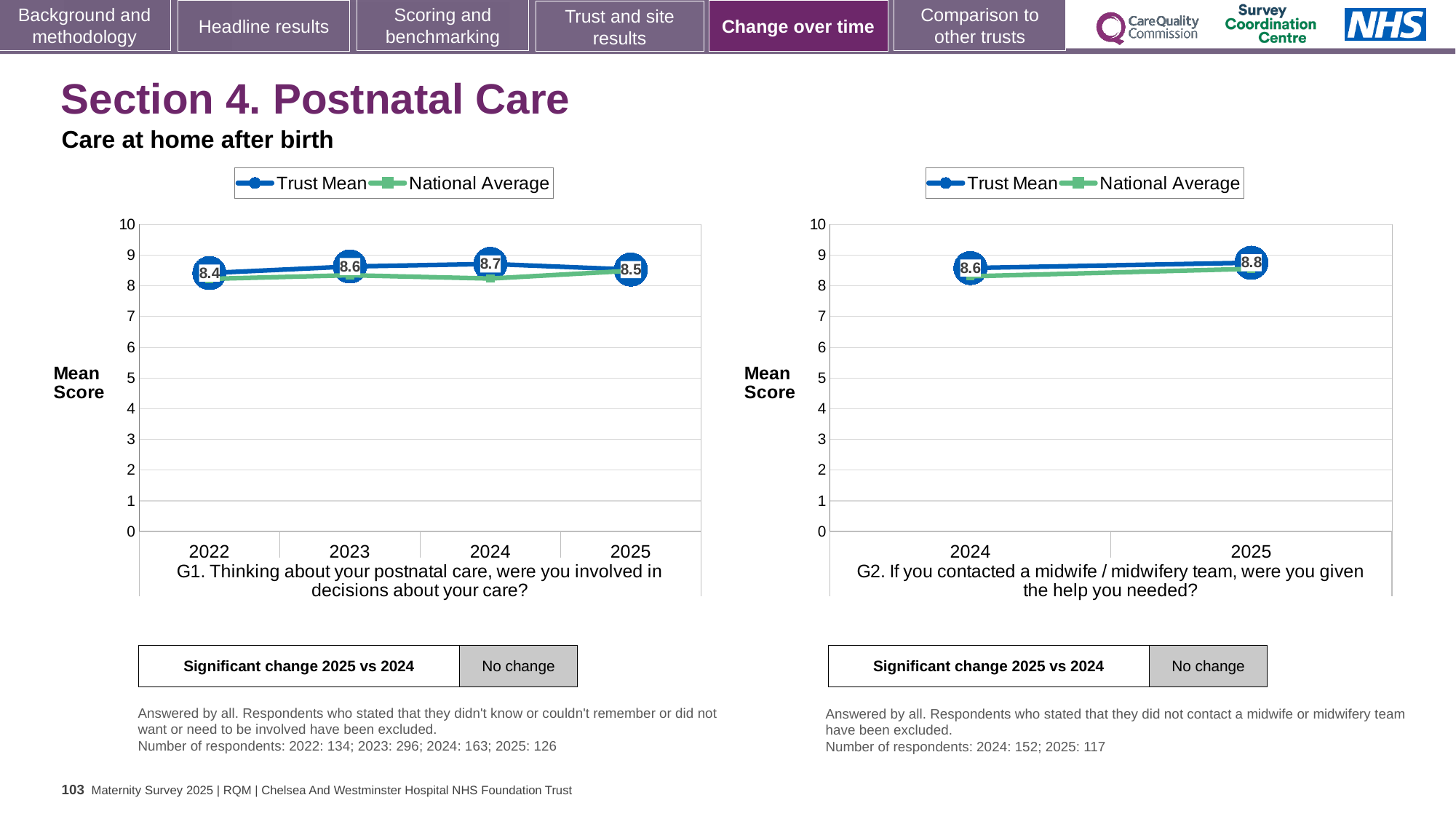
On the G1 chart (left), what is the Trust Mean for 2024? 8.7 On the G1 chart (left), is the Trust Mean for 2023 greater or less than 8? greater What kind of chart is the G2 chart (right)? Line chart How many years are shown on the x axis of the G1 chart (left)? 4 On the G1 chart (left), which year has the highest Trust Mean? 2024 On the G1 chart (left), which year has the lowest Trust Mean? 2022 On the G2 chart (right), what is the difference between the Trust Mean for 2025 and 2024? 0.2 On the G2 chart (right), what is the Trust Mean for 2025? 8.8 On the G1 chart (left), what is the difference between the Trust Mean for 2024 and 2022? 0.3 On the G2 chart (right), what is the Trust Mean for 2024? 8.6 On the G1 chart (left), what is the Trust Mean for 2022? 8.4 How many series does the legend of the G2 chart (right) list? 2